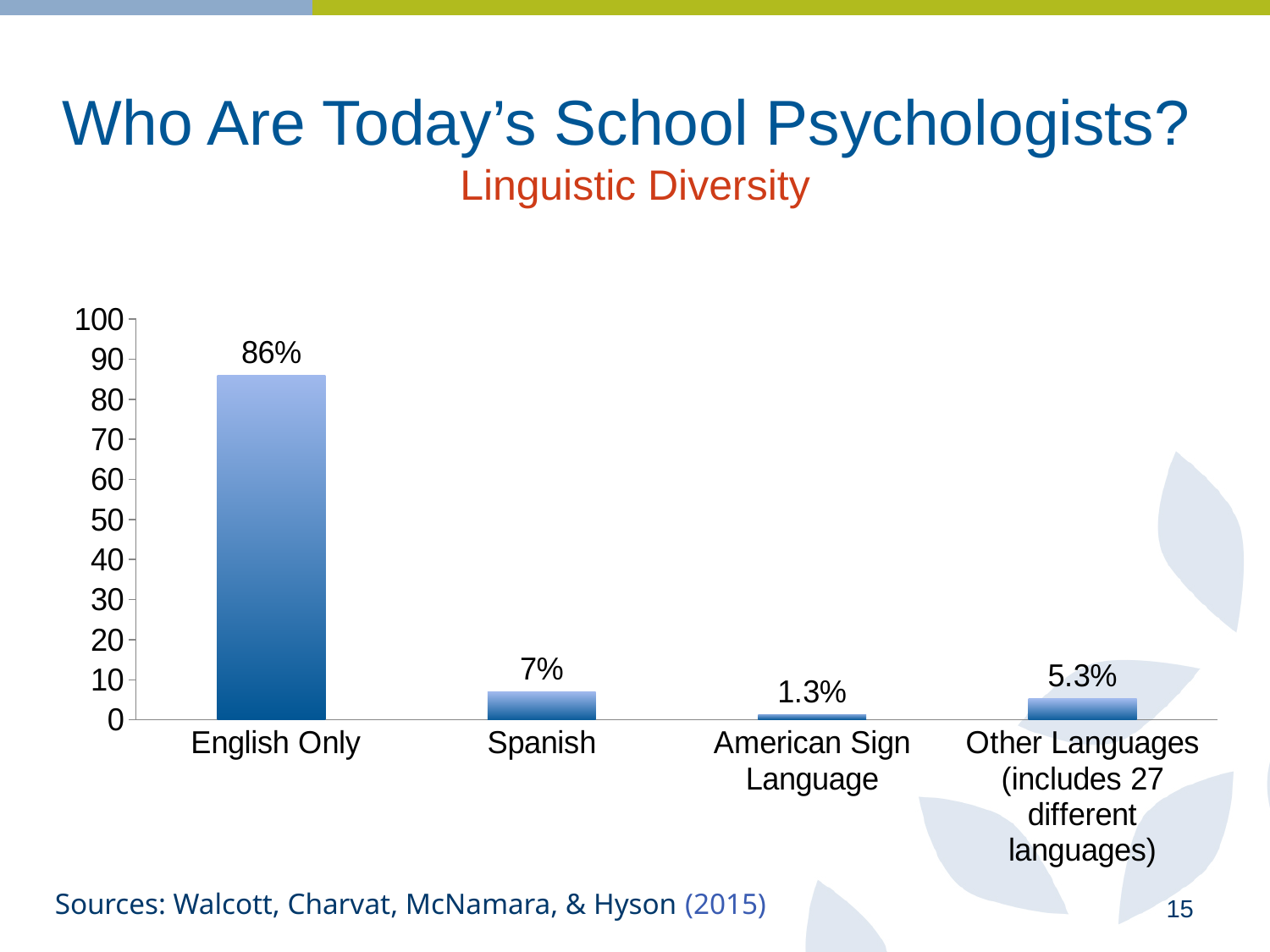
Which category has the lowest value? American Sign Language How many categories are shown on the chart? 4 What is the value for English Only? 86% Which category has the highest value? English Only What is the value for Other Languages (includes 27 different languages)? 5.3% Is the value for English Only greater or less than 80? greater What is the difference between the values for English Only and Spanish? 79% What is the value for American Sign Language? 1.3% What kind of chart is shown on the slide? bar chart Which is larger, the value for Spanish or the value for Other Languages? Spanish What is the difference between the values for Other Languages and American Sign Language? 4% What is the value for Spanish? 7%